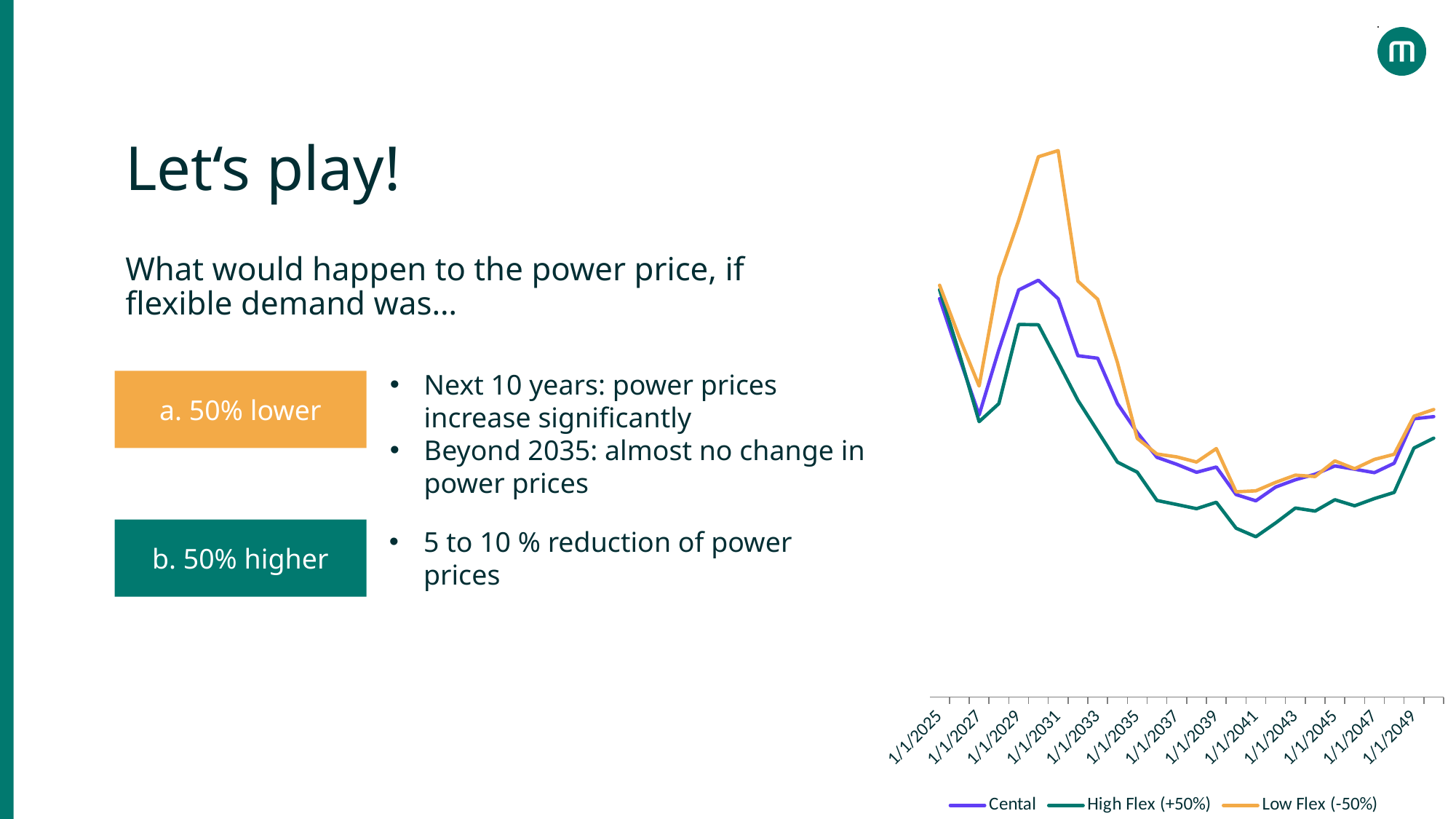
Which series is shown in purple in the chart? Cental What is the first date label on the x axis of the chart? 1/1/2025 Which series is shown in orange in the chart? Low Flex (-50%) Around 1/1/2031, is the Cental series higher or lower than the High Flex (+50%) series? higher Which series reaches the highest peak around 1/1/2031? Low Flex (-50%) What kind of chart is shown on the slide? line chart Around 1/1/2031, is the Low Flex (-50%) series higher or lower than the Cental series? higher Do the series rise or fall between 1/1/2031 and 1/1/2041? fall How many series does the chart legend list? 3 Do the series rise or fall between 1/1/2027 and 1/1/2031? rise Which series is shown in green in the chart? High Flex (+50%) Which series has the lowest values around 1/1/2041? High Flex (+50%)